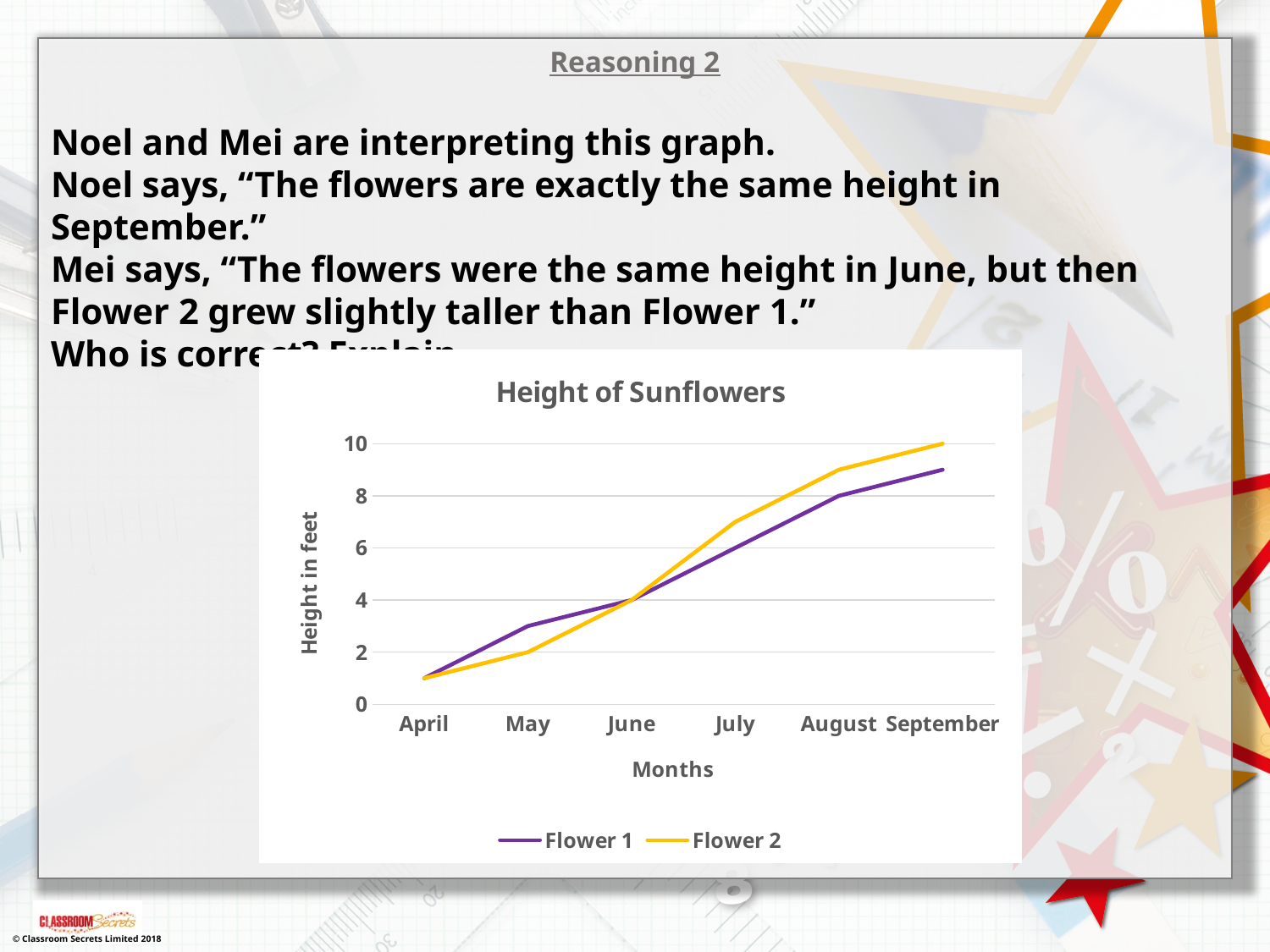
Is the height of Flower 1 in September greater or less than 10? less Which flower is taller in August, Flower 1 or Flower 2? Flower 2 What is the height of Flower 2 in September? 10 Do the heights of Flower 1 rise or fall from April to September? rise What is the height of Flower 1 in August? 8 Which flower is taller in May, Flower 1 or Flower 2? Flower 1 What is the title of the chart? Height of Sunflowers How many months are shown on the x axis? 6 What is the height of Flower 1 in June? 4 How many series does the legend list? 2 Is the height of Flower 2 in July greater or less than 6? greater What kind of chart is shown on the slide? line chart